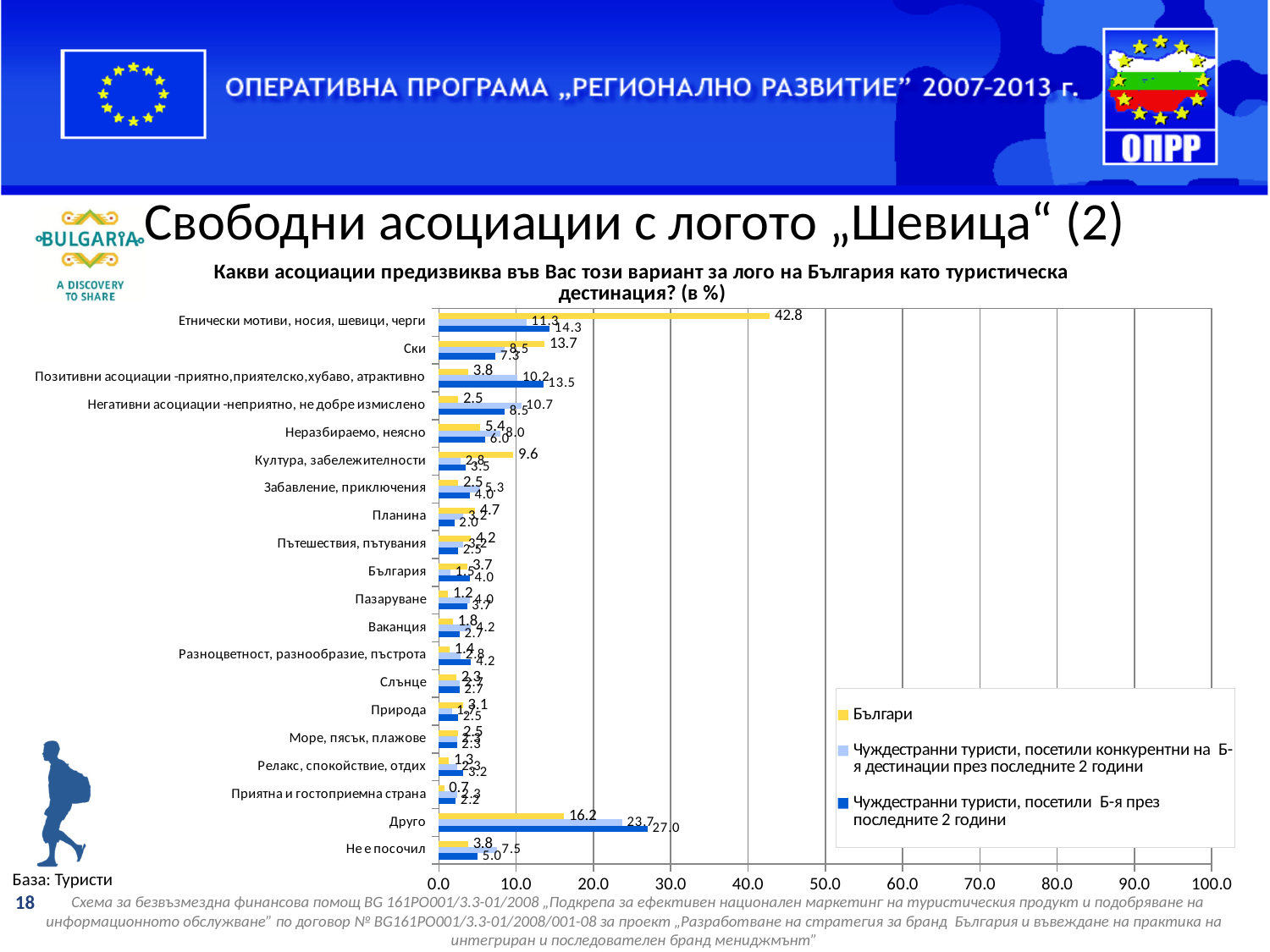
For Българи, which is larger: the value for "Ски" or the value for "Позитивни асоциации -приятно,приятелско,хубаво, атрактивно"? Ски What kind of chart is shown on the slide? bar chart How many series does the legend list? 3 Which category has the highest value for Българи? Етнически мотиви, носия, шевици, черги In the category "Етнически мотиви, носия, шевици, черги", what is the difference between the value for Българи and the value for "Чуждестранни туристи, посетили Б-я през последните 2 години"? 28.5 What is the value for Българи in the category "Етнически мотиви, носия, шевици, черги"? 42.8 Which category has the lowest value for Българи? Приятна и гостоприемна страна Is the value for "Чуждестранни туристи, посетили конкурентни на Б-я дестинации през последните 2 години" in the category "Друго" greater or less than 20.0? greater What is the value for "Чуждестранни туристи, посетили Б-я през последните 2 години" in the category "Друго"? 27.0 What is the value for Българи in the category "Култура, забележителности"? 9.6 What colour represents the series Българи in the chart? yellow How many categories are plotted on the vertical axis? 20